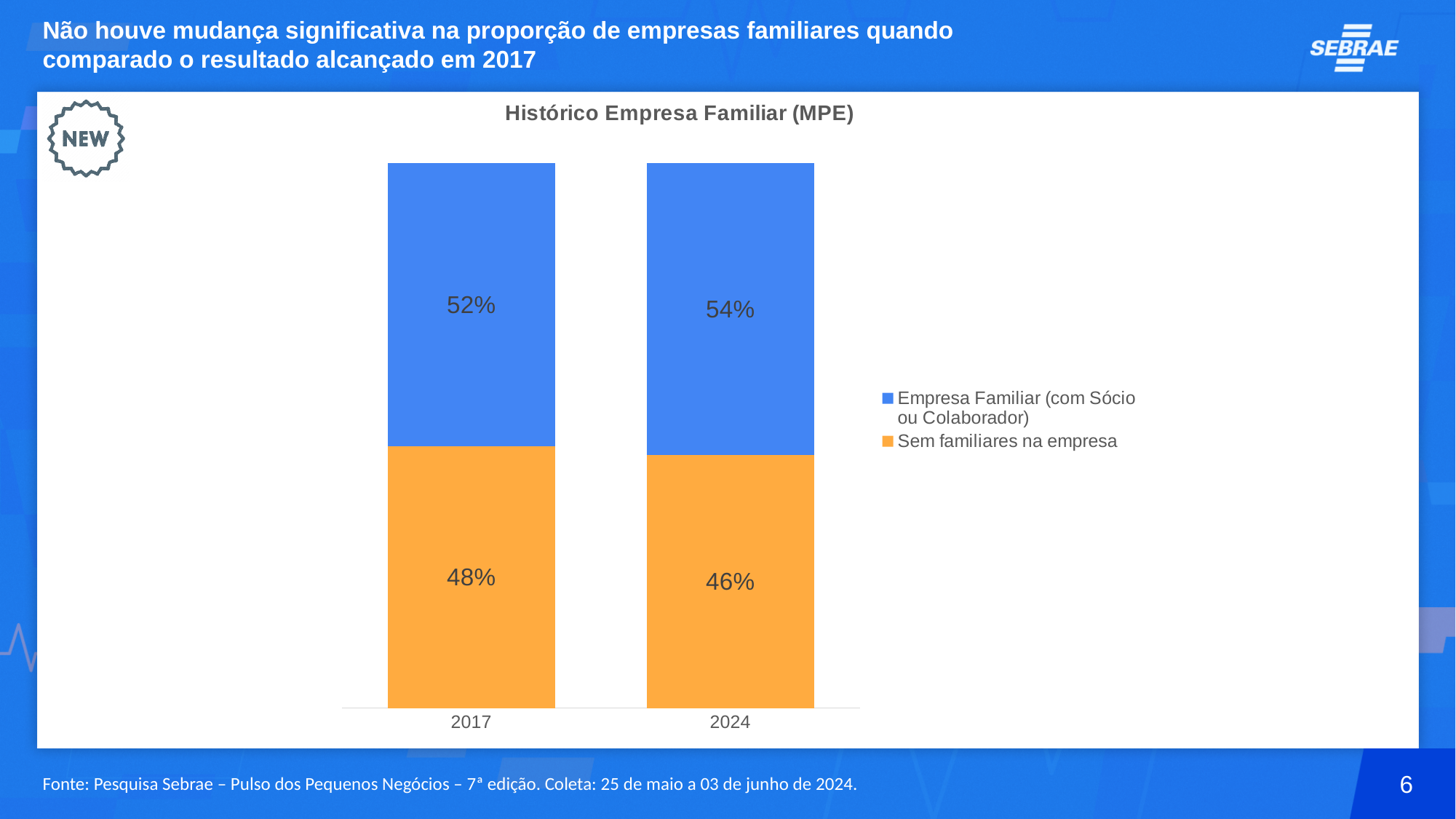
What is the value for Sem familiares na empresa in 2017? 48% In which year is the share of Sem familiares na empresa lower? 2024 What is the value for Empresa Familiar (com Sócio ou Colaborador) in 2024? 54% What is the title of the chart? Histórico Empresa Familiar (MPE) How many years are shown on the x axis of the chart? 2 In which year is the share of Empresa Familiar (com Sócio ou Colaborador) higher? 2024 What kind of chart is shown on the slide? Stacked bar chart What is the value for Sem familiares na empresa in 2024? 46% How many series does the legend list? 2 What is the value for Empresa Familiar (com Sócio ou Colaborador) in 2017? 52% What is the difference between the Empresa Familiar share in 2024 and in 2017? 2% Which is larger in 2017: Empresa Familiar (com Sócio ou Colaborador) or Sem familiares na empresa? Empresa Familiar (com Sócio ou Colaborador)